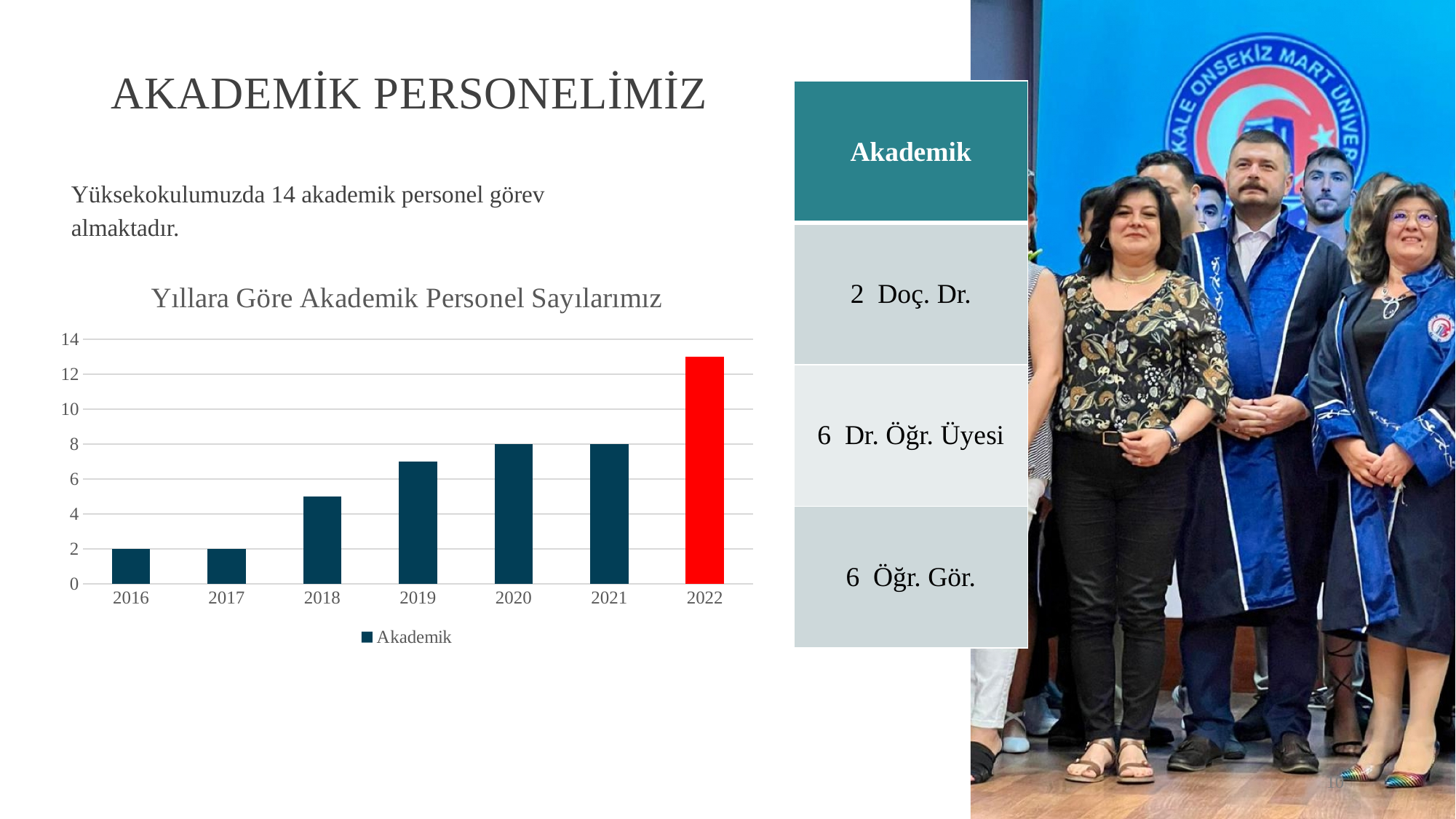
Do the values generally rise or fall from 2016 to 2022? rise What is the title of the chart? Yıllara Göre Akademik Personel Sayılarımız How many years (categories) are shown on the x axis of the chart? 7 How many series does the chart legend list? 1 What is the value for 2020 in the chart? 8 What is the value for 2021 in the chart? 8 What is the difference between the values for 2020 and 2016? 6 Is the value for 2018 greater or less than 4? greater Is the value for 2019 greater or less than 8? less What type of chart is shown on the slide? bar chart What is the value for 2016 in the chart? 2 Which year has the highest value in the chart? 2022